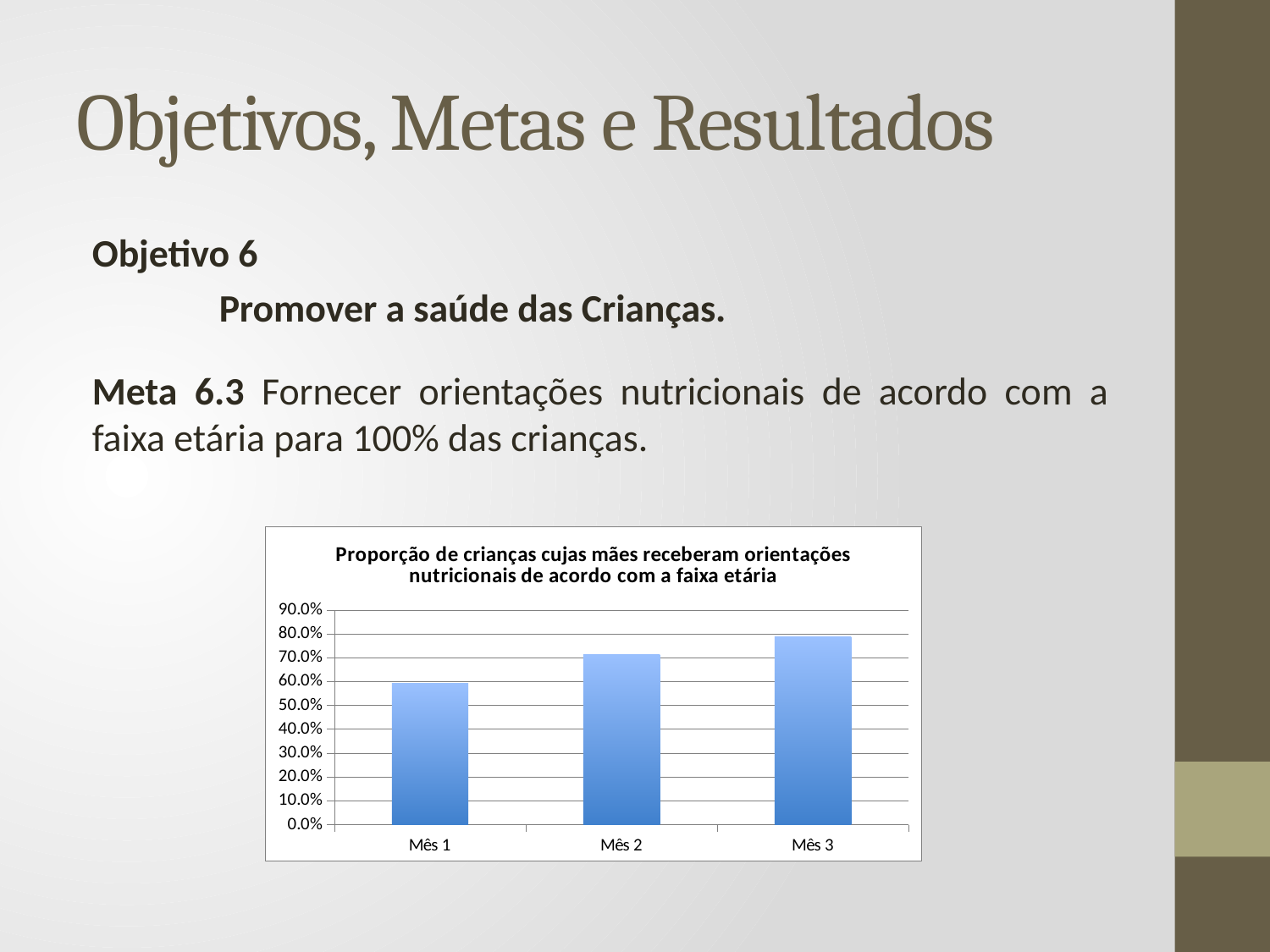
Is the value for Mês 2 greater or less than 60.0%? greater Is the value for Mês 1 greater or less than 50.0%? greater Which month has the lowest value on the chart? Mês 1 What is the title of the chart? Proporção de crianças cujas mães receberam orientações nutricionais de acordo com a faixa etária Is the value for Mês 1 greater or less than 70.0%? less What kind of chart is shown on the slide? bar chart How many categories (months) are plotted on the chart? 3 Do the values rise or fall from Mês 1 to Mês 3? rise Which is larger, the value for Mês 1 or the value for Mês 2? Mês 2 Which month has the highest value on the chart? Mês 3